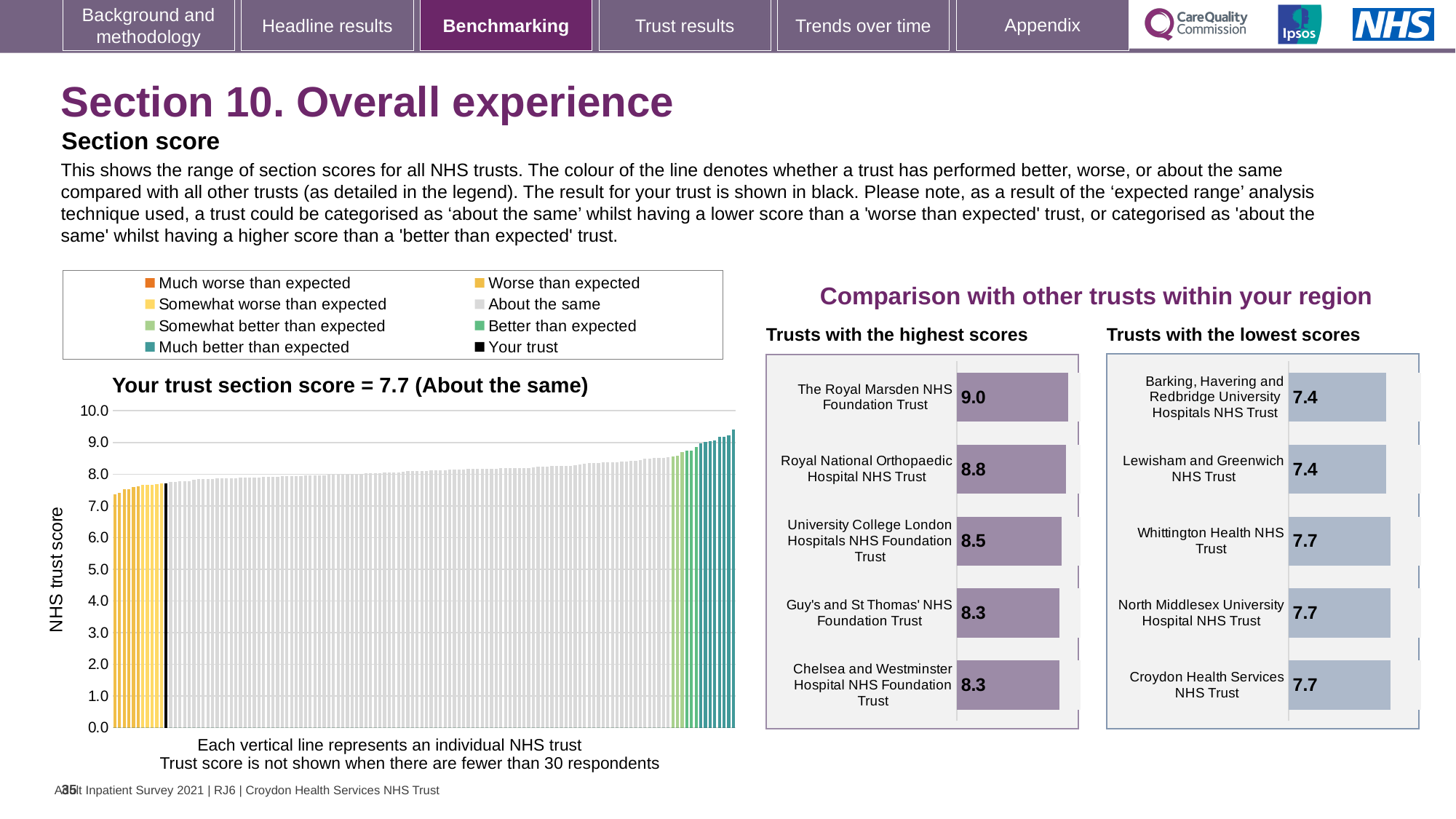
In the 'Trusts with the highest scores' chart, what is the score for The Royal Marsden NHS Foundation Trust? 9.0 In the 'Your trust section score' chart, how many entries does the legend list? 8 In the 'Your trust section score' chart, is the value of the highest bar greater or less than 9.0? greater In the 'Your trust section score' chart, what is the label on the vertical axis? NHS trust score In the 'Your trust section score' chart, what is the section score for your trust? 7.7 In the 'Trusts with the highest scores' chart, which trust has the highest score? The Royal Marsden NHS Foundation Trust In the 'Trusts with the highest scores' chart, what is the difference between the scores of The Royal Marsden NHS Foundation Trust and Royal National Orthopaedic Hospital NHS Trust? 0.2 In the 'Trusts with the lowest scores' chart, which is larger, the score for Whittington Health NHS Trust or the score for Lewisham and Greenwich NHS Trust? Whittington Health NHS Trust In the 'Trusts with the lowest scores' chart, how many trusts are shown? 5 What kind of chart is the 'Your trust section score' chart? bar chart In the 'Trusts with the lowest scores' chart, what is the score for Lewisham and Greenwich NHS Trust? 7.4 In the 'Your trust section score' chart, do the trust scores rise or fall from left to right? rise